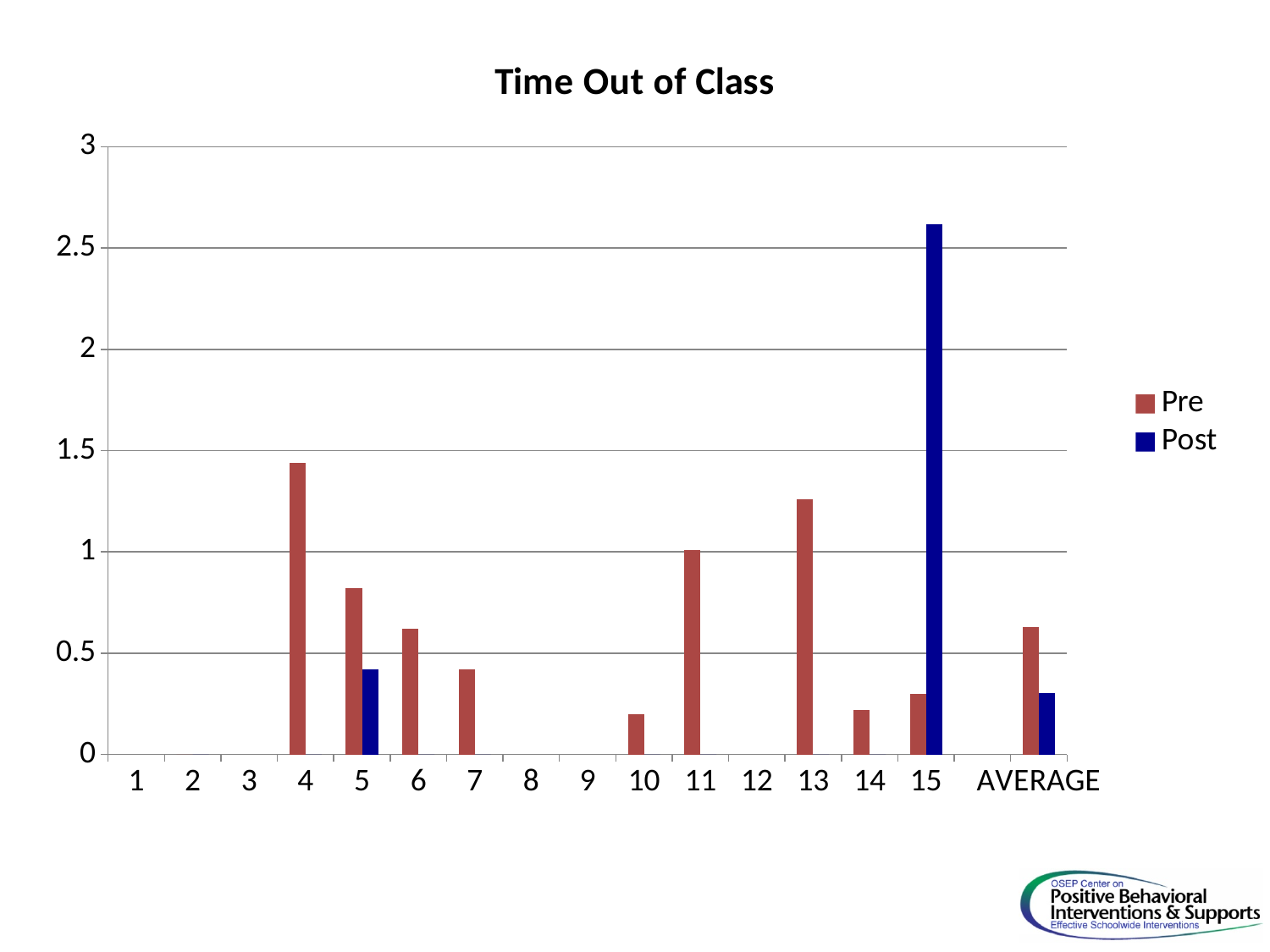
What is the title of the chart? Time Out of Class How many categories are shown on the x axis? 16 Which is larger, the Pre value for category 4 or the Pre value for category 13? Pre value for category 4 What kind of chart is shown on the slide? bar chart For category 15, which is larger, the Pre value or the Post value? Post Is the Pre value for category 4 greater or less than 1? greater Is the Post value for category 15 greater or less than 2.5? greater Which category has the highest Post value? 15 For AVERAGE, which is larger, the Pre value or the Post value? Pre Is the Pre value for category 10 greater or less than 0.5? less Which category has the highest Pre value? 4 How many series does the legend list? 2